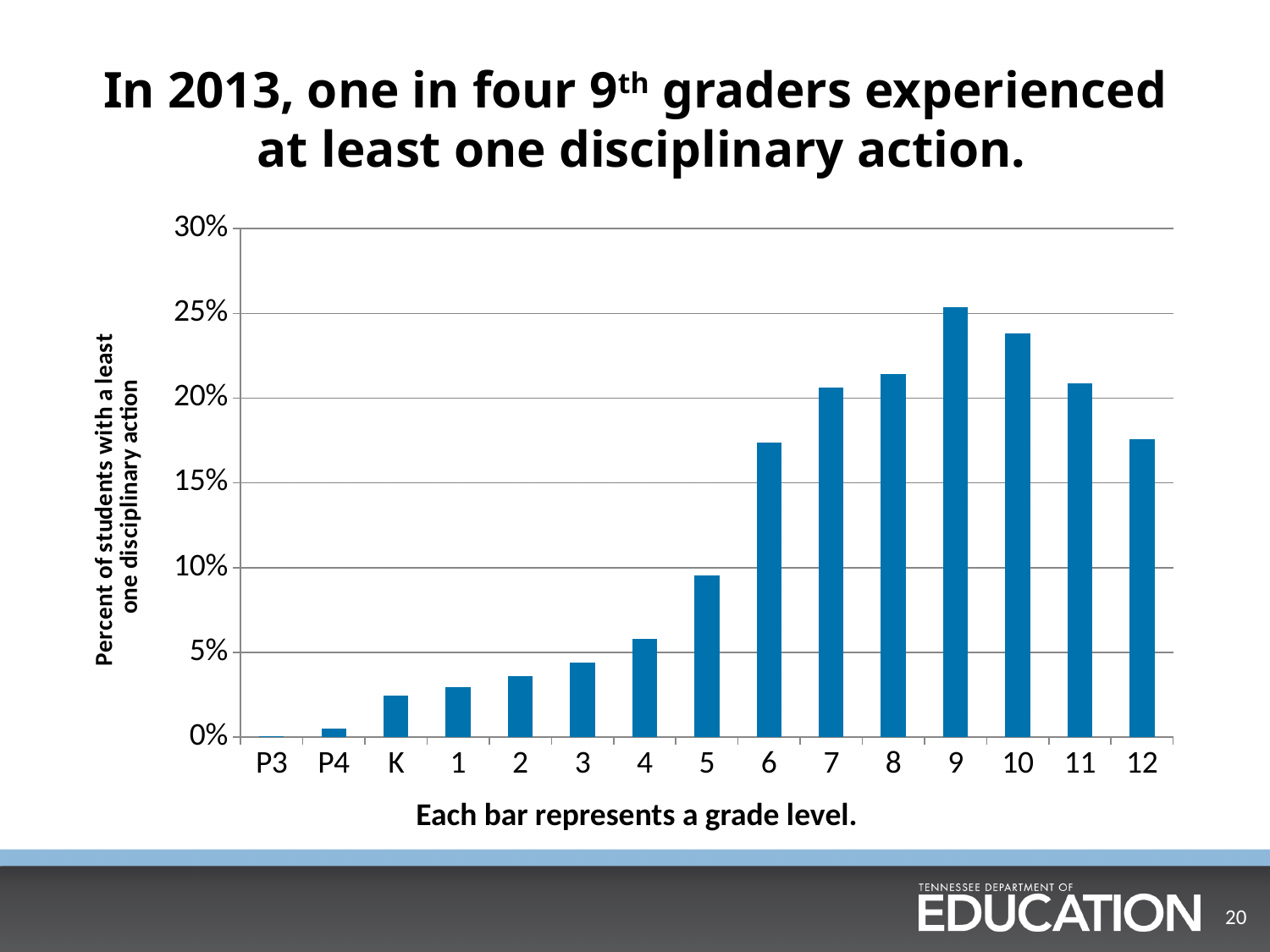
What kind of chart is shown on the slide? bar chart Which grade level has the lowest percent of students with at least one disciplinary action? P3 How many grade levels (bars) are shown in the chart? 15 Which grade level has the highest percent of students with at least one disciplinary action? 9 Which has a higher percent of students with a disciplinary action, grade 6 or grade 7? 7 Which has a higher percent of students with a disciplinary action, grade 11 or grade 12? 11 Do the values rise or fall from grade 9 to grade 12? fall Is the value for K greater or less than 5%? less Is the value for grade 5 greater or less than 10%? less Is the value for grade 9 greater or less than 20%? greater What is the label of the vertical axis? Percent of students with a least one disciplinary action